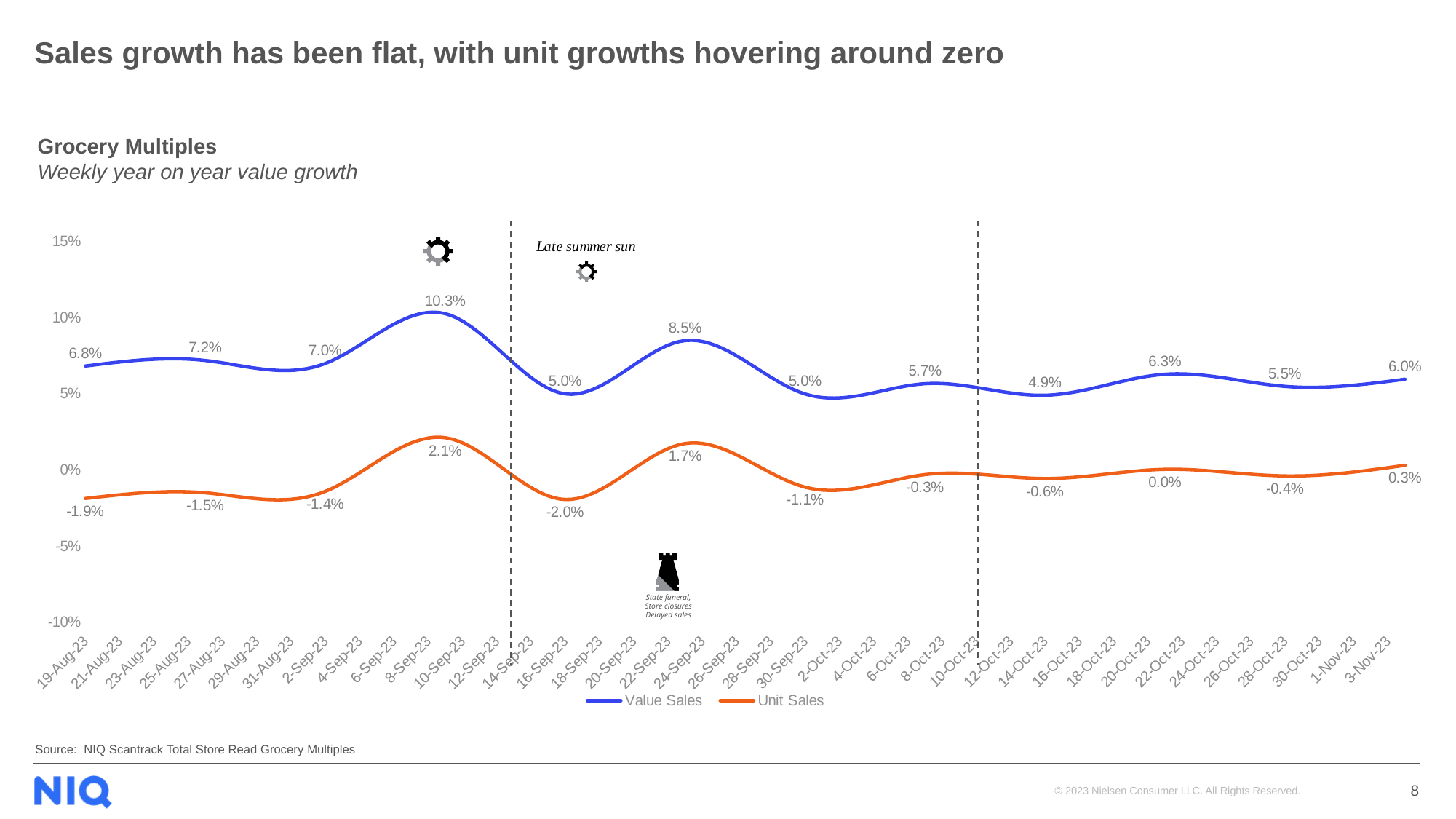
What are the two series named in the legend? Value Sales and Unit Sales What is the lowest labelled value on the Unit Sales line? -2.0% What is the highest labelled value on the Value Sales line? 10.3% How many series does the legend list? 2 What is the last labelled value on the Unit Sales line, at the right end of the chart? 0.3% Is the first Value Sales label (6.8%) higher or lower than the last Value Sales label (6.0%)? Higher How many labelled data points are there on the Value Sales line? 12 What is the first labelled value on the Value Sales line, at 19-Aug-23? 6.8% What is the highest labelled value on the Unit Sales line? 2.1% What is the lowest labelled value on the Value Sales line? 4.9% What type of chart is shown on the slide? Line chart What is the difference between the peak Value Sales label (10.3%) and the peak Unit Sales label (2.1%)? 8.2 percentage points